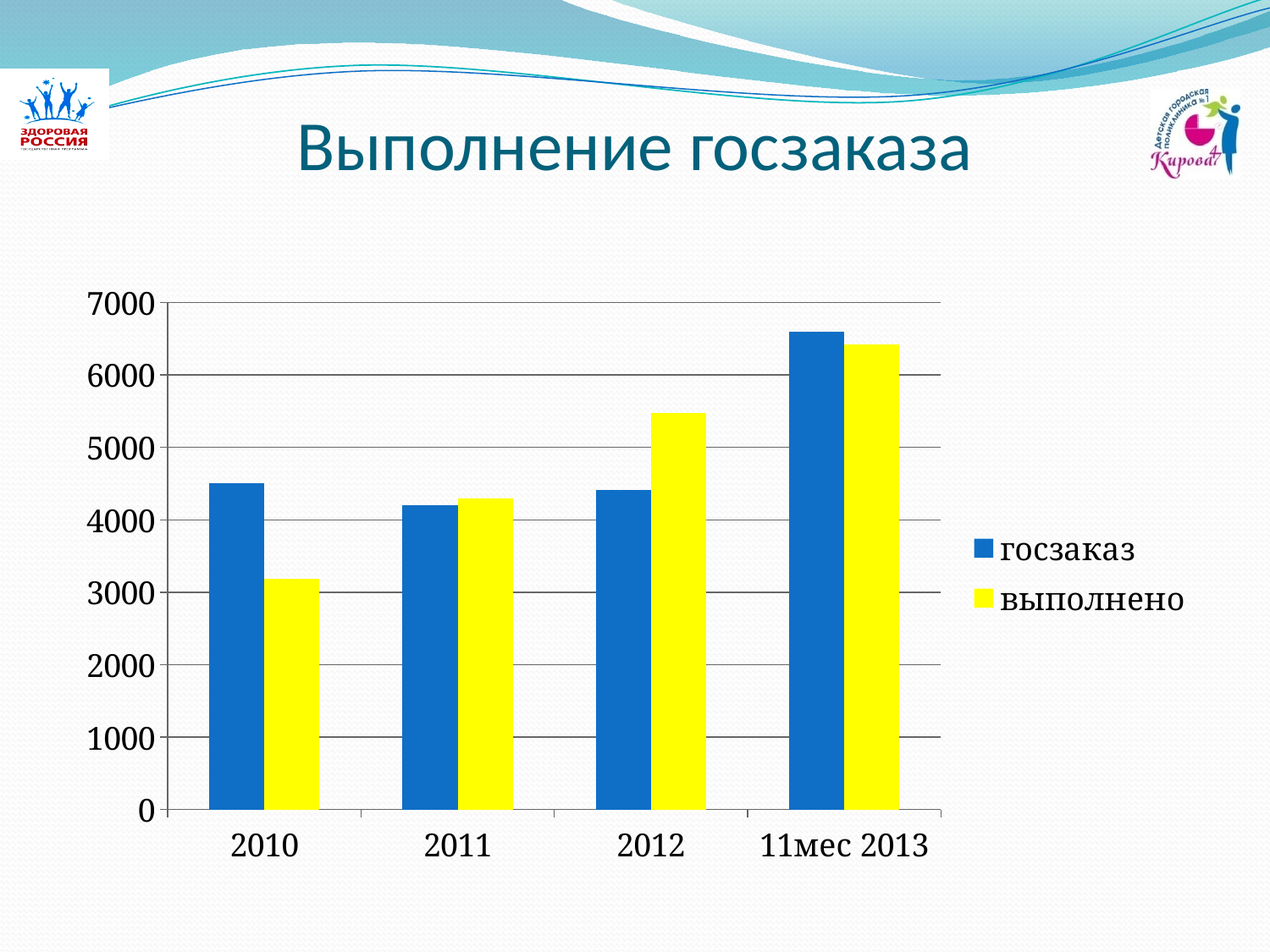
Which category has the lowest value for выполнено? 2010 What is the title of the chart? Выполнение госзаказа What kind of chart is shown on the slide? bar chart Which category has the highest value for госзаказ? 11мес 2013 How many series does the legend list? 2 Is the value for выполнено in 2012 greater or less than 5000? greater Do the values for выполнено rise or fall from 2010 to 11мес 2013? rise How many categories are shown on the x axis? 4 Is the value for госзаказ in 11мес 2013 greater or less than 6000? greater In 2012, which is larger: госзаказ or выполнено? выполнено Is the value for выполнено in 2010 greater or less than 3000? greater